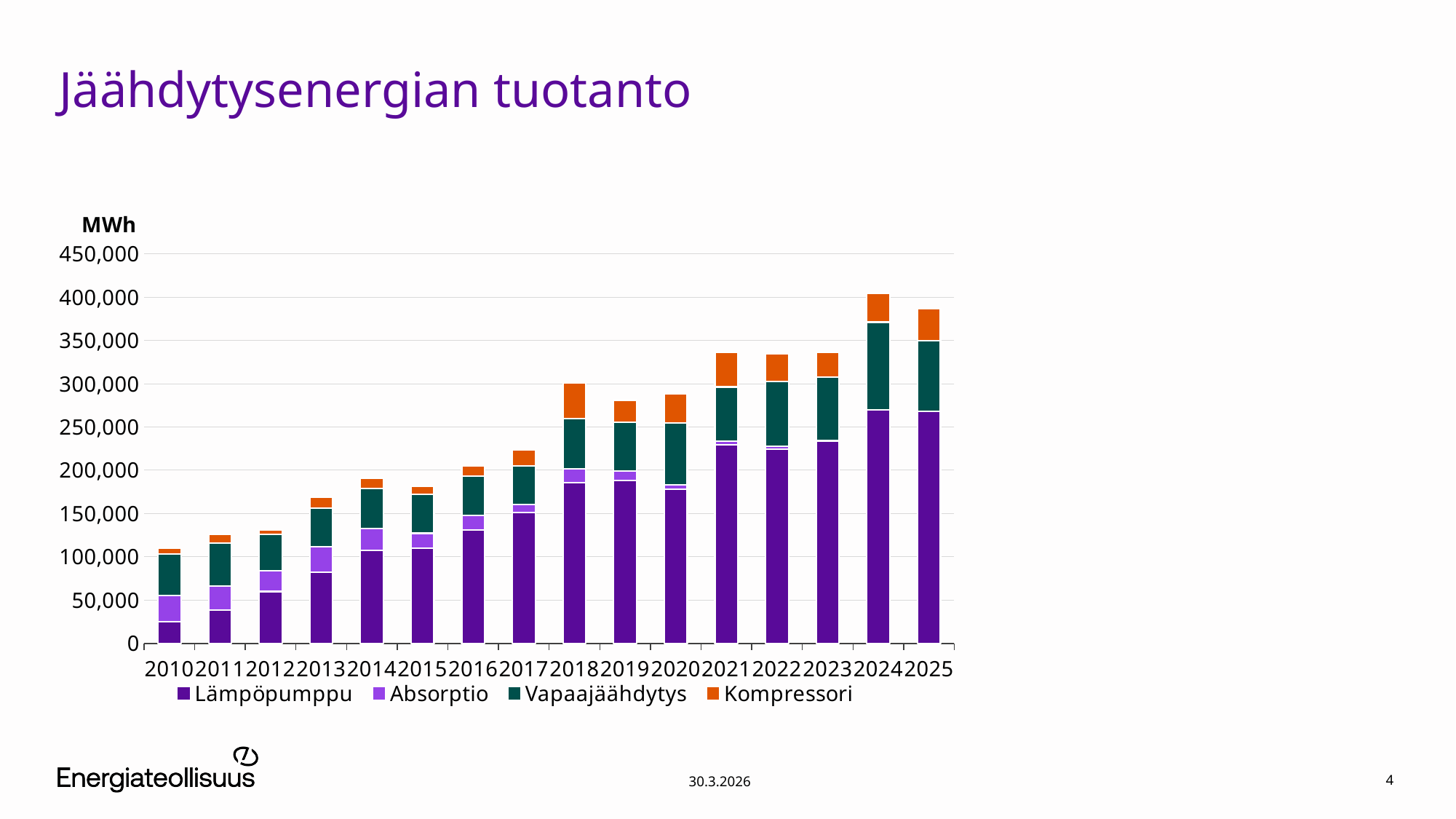
Is the total value for 2013 greater or less than 200,000 MWh? less Is the Lämpöpumppu value for 2025 greater or less than 250,000 MWh? greater Do the total values generally rise or fall from 2010 to 2025? rise Which year has a larger total, 2024 or 2025? 2024 What kind of chart is shown on the slide? Stacked bar chart Which year has the lowest total cooling energy production? 2010 Is the total value for 2024 greater or less than 350,000 MWh? greater Which year has the highest total cooling energy production? 2024 How many series does the chart legend list? 4 How many years are shown on the x axis of the chart? 16 What unit is shown on the y axis of the chart? MWh